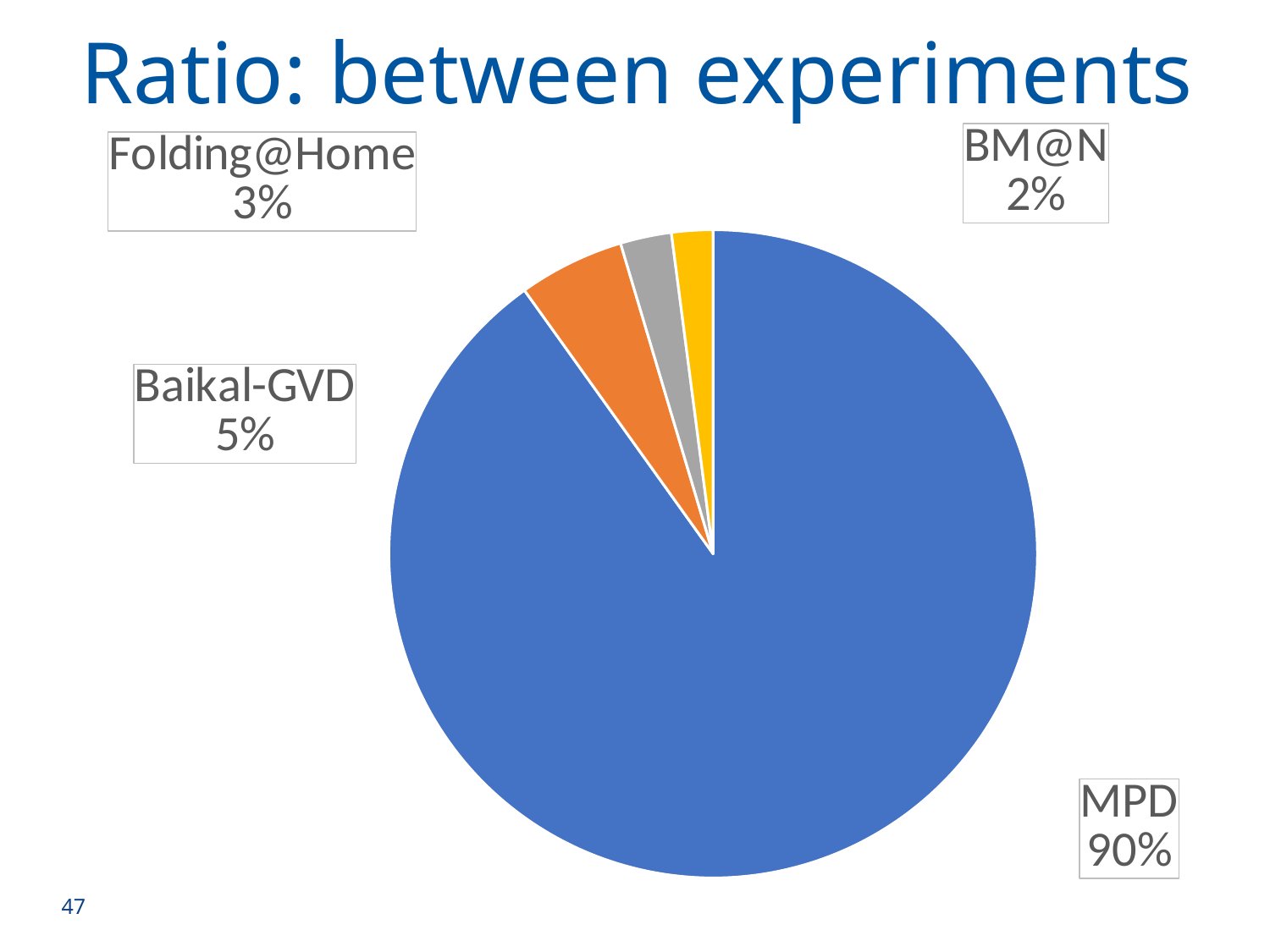
What share of the pie does Folding@Home have? 3% Which slice is larger, Baikal-GVD or BM@N? Baikal-GVD What share of the pie does BM@N have? 2% What kind of chart is shown on the slide? Pie chart What share of the pie does MPD have? 90% How many slices does the pie chart have? 4 Which experiment has the largest slice of the pie? MPD Which experiment has the smallest slice of the pie? BM@N What is the difference in percentage points between the Baikal-GVD and Folding@Home slices? 2 What is the title of the slide containing the chart? Ratio: between experiments What is the difference in percentage points between the MPD and Baikal-GVD slices? 85